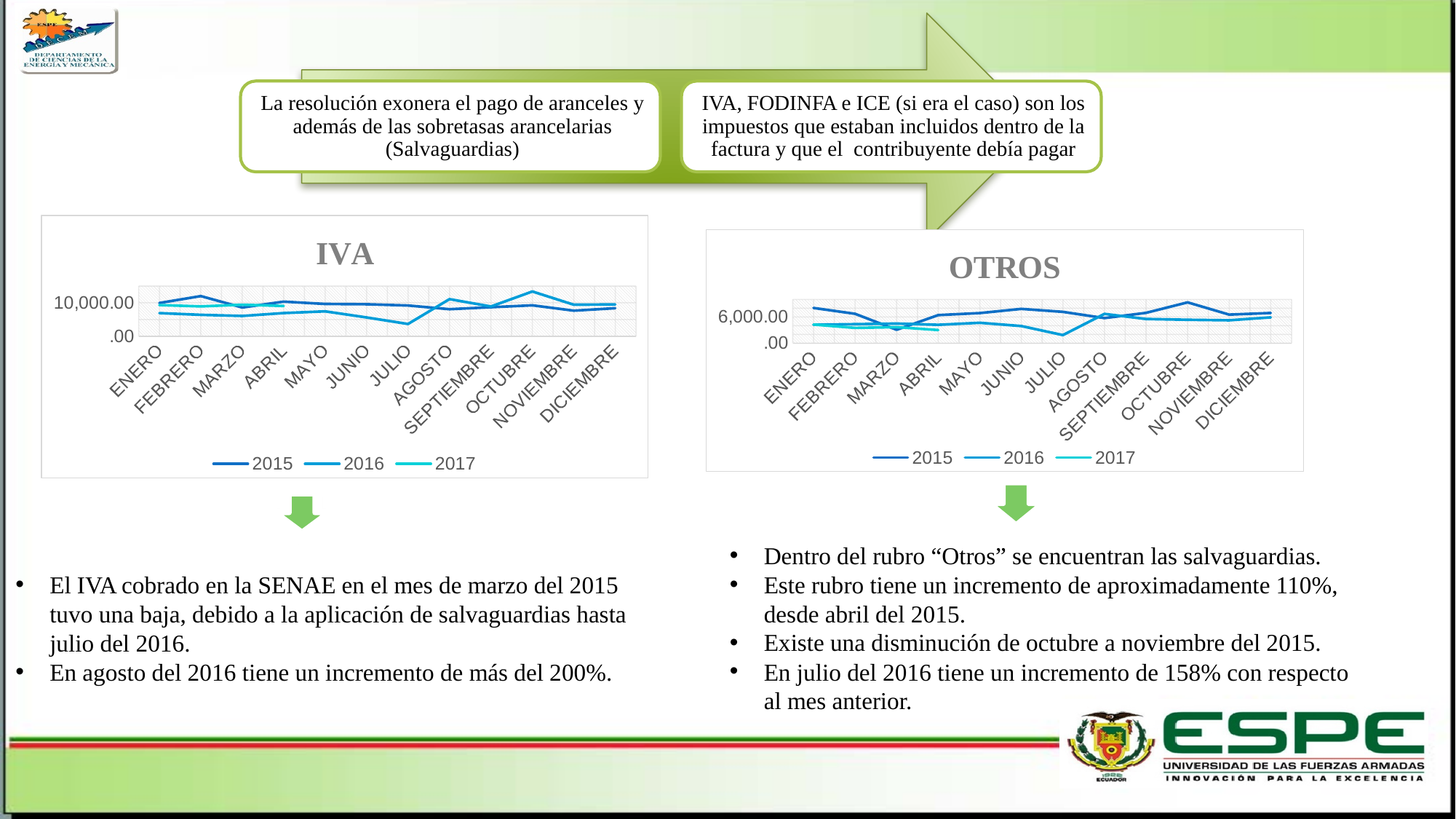
In the OTROS chart, is the 2016 value for JULIO greater or less than 6,000.00? less In the IVA chart, is the 2016 value for ENERO greater or less than 10,000.00? less In the IVA chart, is the 2016 value for OCTUBRE greater or less than 10,000.00? greater What are the series names in the legend of the IVA chart? 2015, 2016, 2017 What kind of chart is the OTROS chart? line chart In the IVA chart, does the 2016 series rise or fall from JULIO to AGOSTO? rise How many months are shown on the x axis of the IVA chart? 12 What kind of chart is the IVA chart? line chart How many series does the legend of the OTROS chart list? 3 What is the title of the chart on the right side of the slide? OTROS